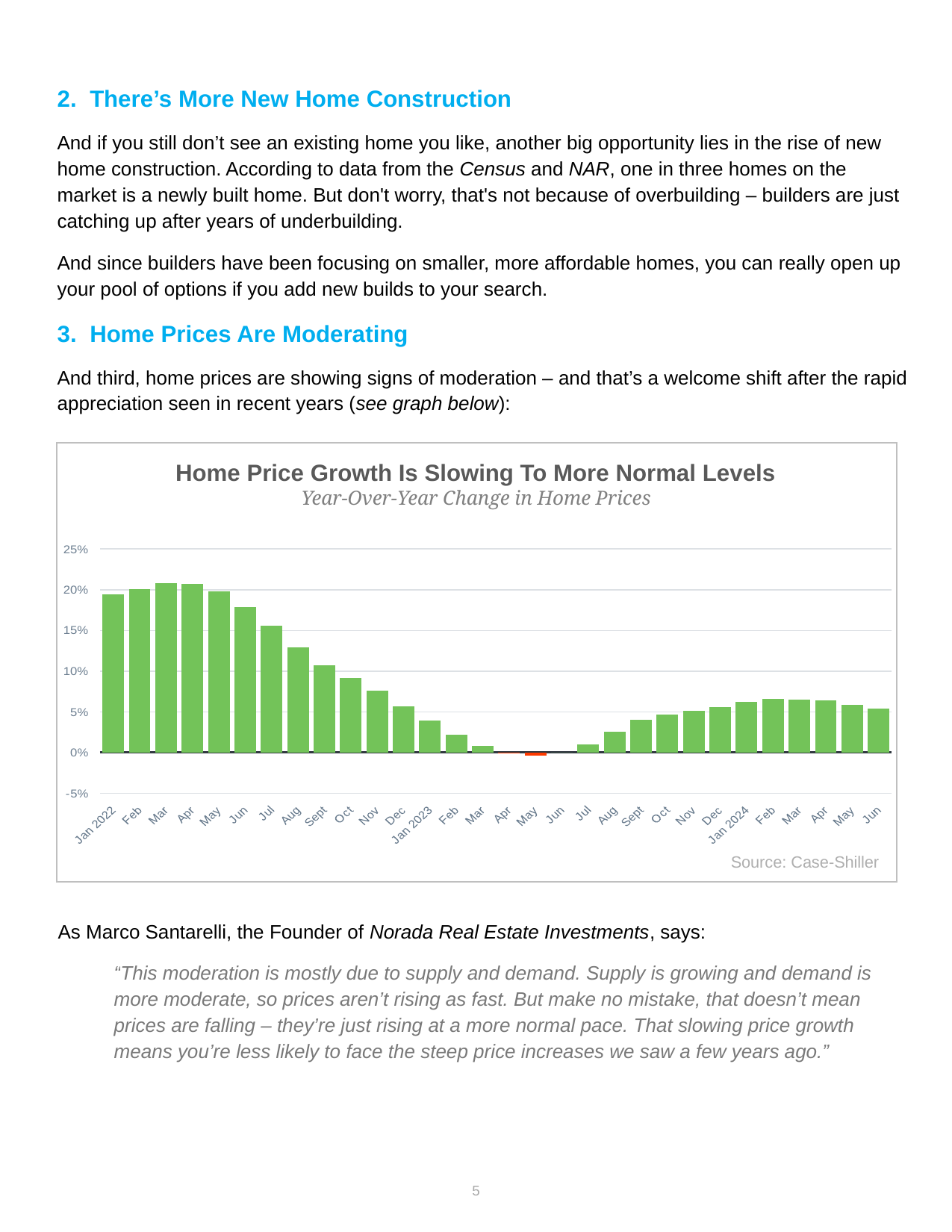
Do the values rise or fall from Jan 2022 to May 2023? fall Is the value for Jan 2022 greater or less than 15%? greater How many months (bars) are plotted in the chart? 30 Which is larger, the value for Mar 2022 or the value for Mar 2024? Mar 2022 Is the value for Jan 2024 greater or less than 10%? less Which is larger, the value for Jul 2022 or the value for Jul 2023? Jul 2022 Is the value for Feb 2023 greater or less than 5%? less What source is cited for the chart's data? Case-Shiller What kind of chart is shown on the slide? bar chart What is the title of the chart? Home Price Growth Is Slowing To More Normal Levels